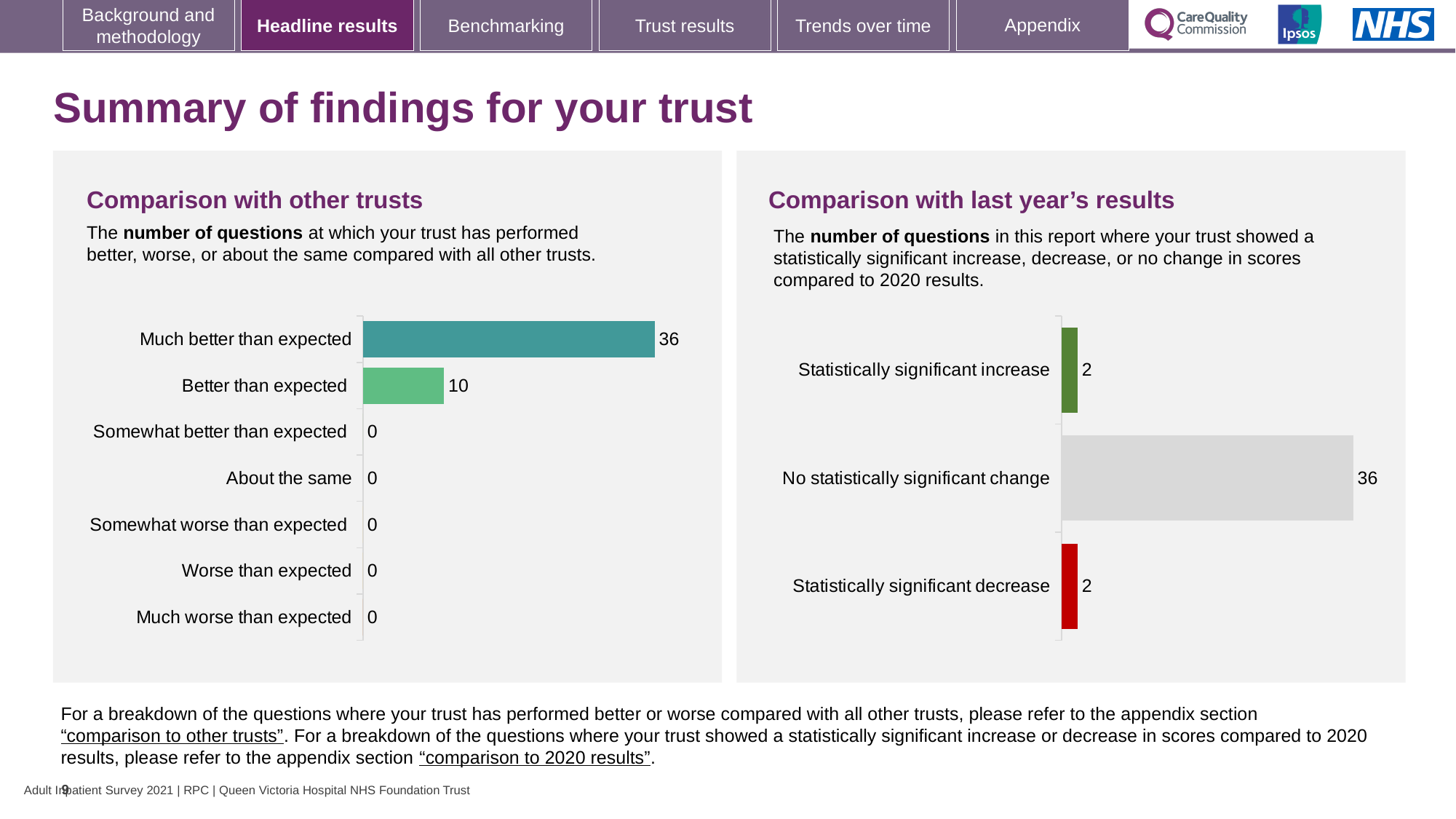
In the 'Comparison with other trusts' chart, what is the value for 'Much better than expected'? 36 What kind of chart is the 'Comparison with other trusts' chart? Bar chart How many categories are shown in the 'Comparison with other trusts' chart? 7 How many categories are shown in the 'Comparison with last year's results' chart? 3 In the 'Comparison with other trusts' chart, which category has the highest value? Much better than expected In the 'Comparison with last year's results' chart, what colour is the bar for 'Statistically significant decrease'? Red In the 'Comparison with other trusts' chart, what is the difference between 'Much better than expected' and 'Better than expected'? 26 In the 'Comparison with other trusts' chart, what is the value for 'About the same'? 0 In the 'Comparison with last year's results' chart, what is the value for 'Statistically significant decrease'? 2 In the 'Comparison with last year's results' chart, which category has the highest value? No statistically significant change In the 'Comparison with last year's results' chart, what is the value for 'No statistically significant change'? 36 In the 'Comparison with other trusts' chart, what is the value for 'Better than expected'? 10